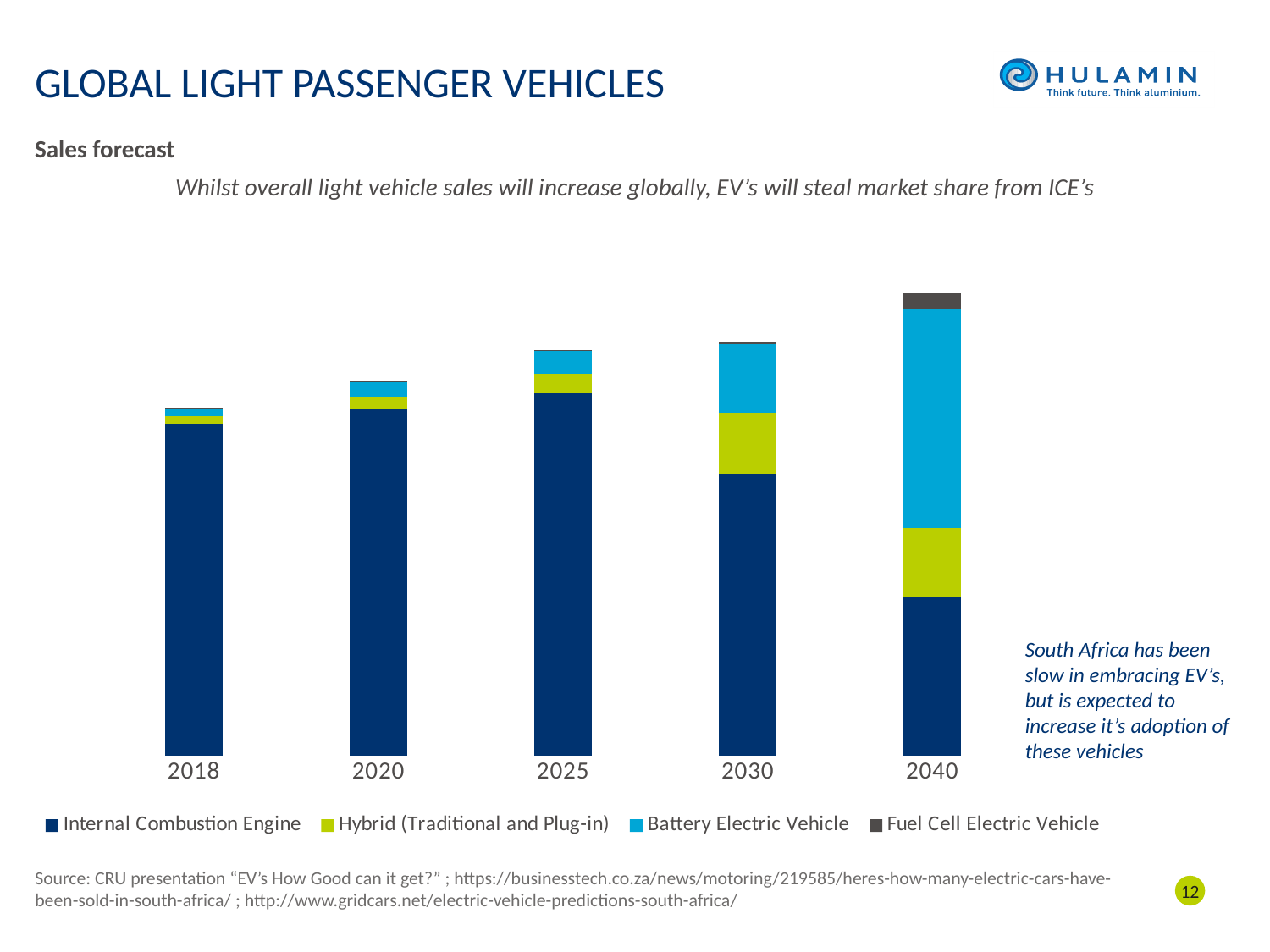
How many series does the chart's legend list? 4 Do the total bar heights rise or fall from 2018 to 2040? Rise Which year has the larger Battery Electric Vehicle segment, 2030 or 2040? 2040 How many years are shown along the x axis of the chart? 5 Which year has the larger Hybrid (Traditional and Plug-in) segment, 2018 or 2030? 2030 Which series is listed last in the chart's legend? Fuel Cell Electric Vehicle What kind of chart is shown on the slide? Stacked bar chart Which year has the tallest total bar in the chart? 2040 In which year does the Internal Combustion Engine segment reach its greatest height? 2025 Which year has the larger Internal Combustion Engine segment, 2025 or 2040? 2025 Which year has the shortest total bar in the chart? 2018 Which series is shown in dark blue in the chart? Internal Combustion Engine